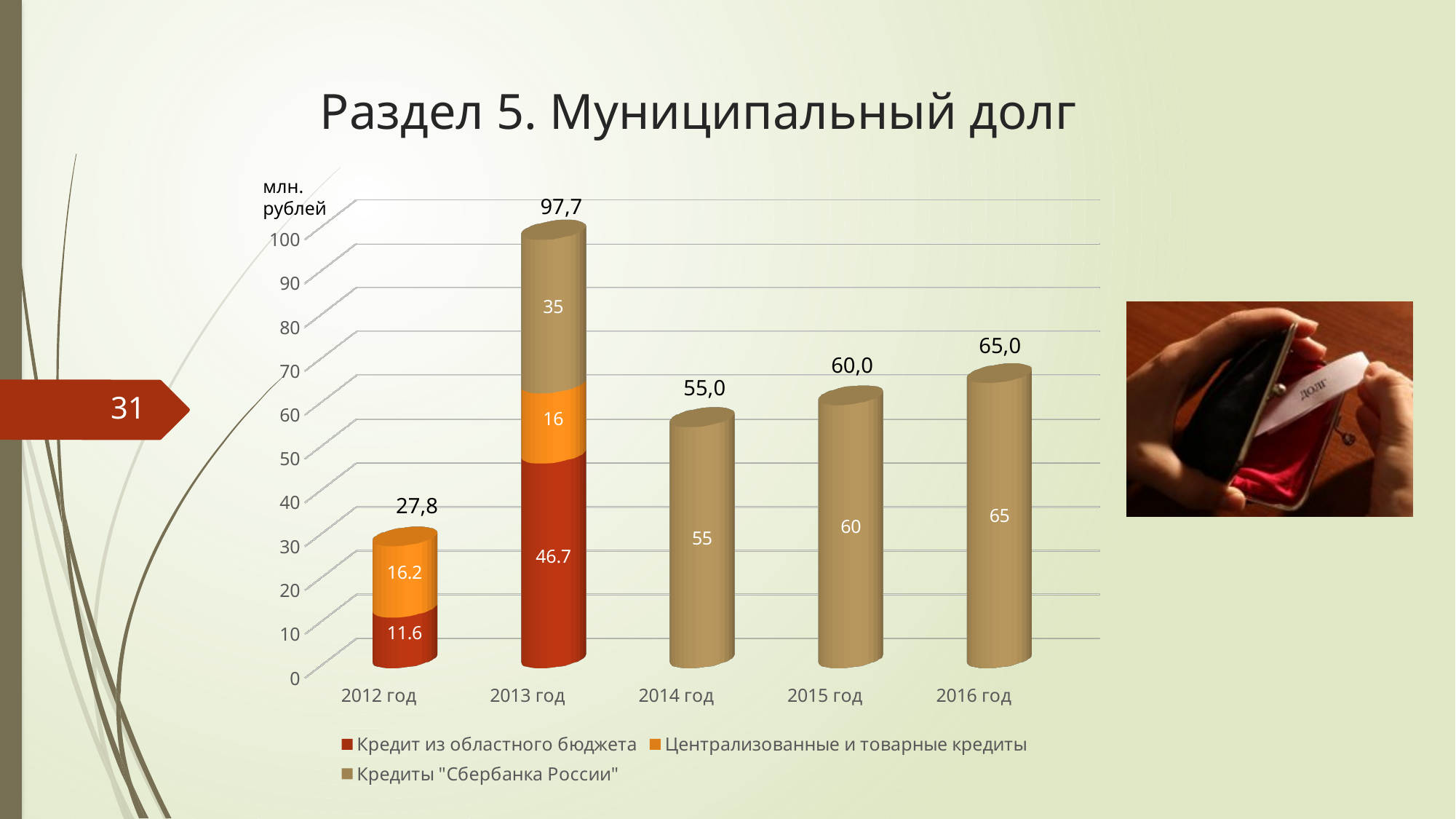
How many years are shown on the x axis? 5 Which year has the lowest total municipal debt? 2012 год How many series does the legend list? 3 What is the difference between the totals for 2016 год and 2015 год? 5,0 What is the total labelled above the bar for 2013 год? 97,7 What is the value of the "Кредит из областного бюджета" segment for 2013 год? 46.7 What is the value of the "Централизованные и товарные кредиты" segment for 2012 год? 16.2 What is the total labelled above the bar for 2012 год? 27,8 What kind of chart is shown on the slide? Stacked bar chart Which is larger, the total for 2014 год or the total for 2016 год? 2016 год Which year has the highest total municipal debt? 2013 год What is the value of the "Кредиты "Сбербанка России"" segment for 2013 год? 35